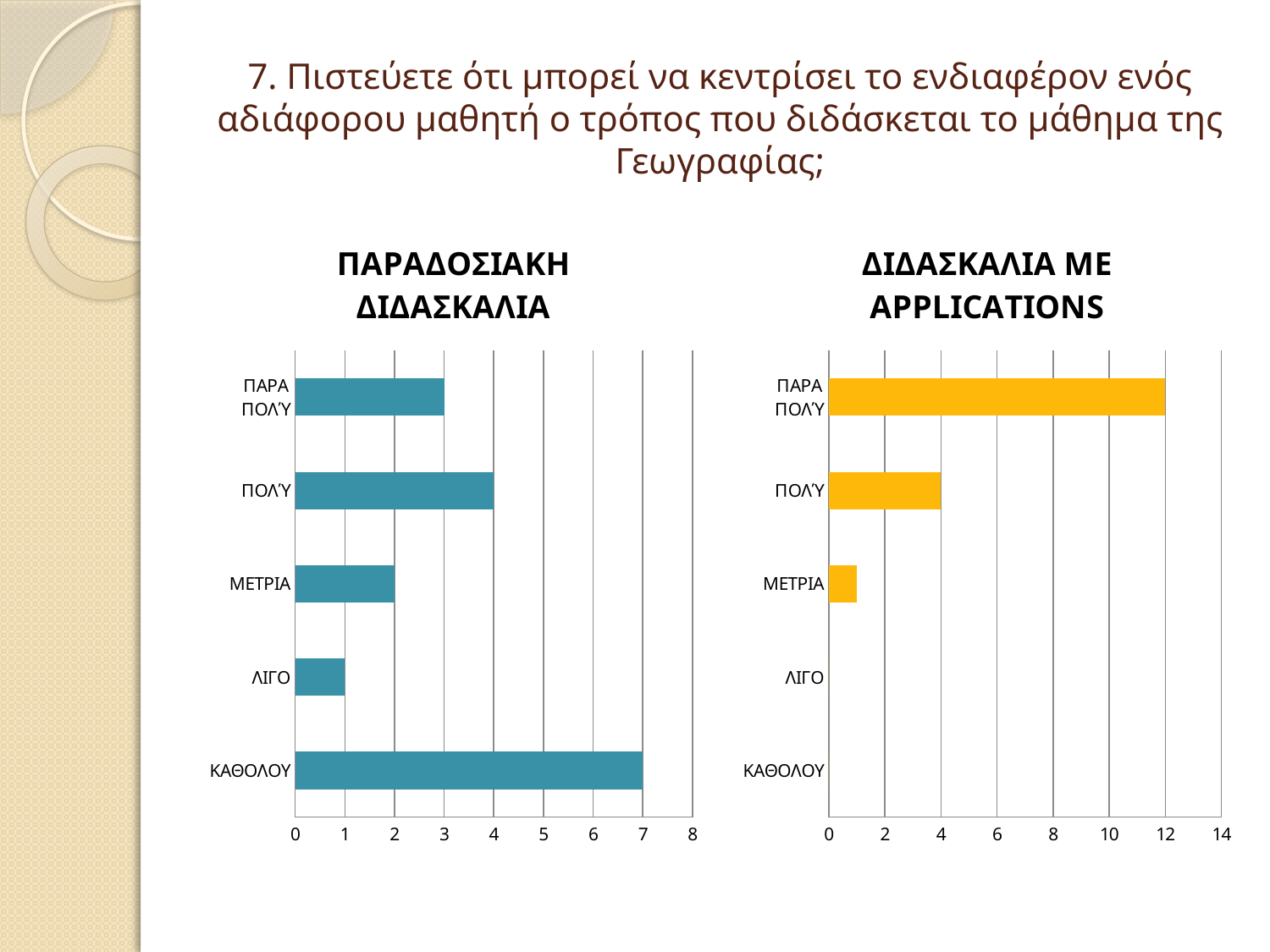
In the ΠΑΡΑΔΟΣΙΑΚΗ ΔΙΔΑΣΚΑΛΙΑ chart, which category has the lowest value? ΛΙΓΟ Which is larger: the value for ΠΑΡΑ ΠΟΛΎ in the ΠΑΡΑΔΟΣΙΑΚΗ ΔΙΔΑΣΚΑΛΙΑ chart or in the ΔΙΔΑΣΚΑΛΙΑ ΜΕ APPLICATIONS chart? ΔΙΔΑΣΚΑΛΙΑ ΜΕ APPLICATIONS In the ΔΙΔΑΣΚΑΛΙΑ ΜΕ APPLICATIONS chart, is the value for ΜΕΤΡΙΑ greater or less than 2? less In the ΠΑΡΑΔΟΣΙΑΚΗ ΔΙΔΑΣΚΑΛΙΑ chart, what is the difference between the values for ΚΑΘΟΛΟΥ and ΠΟΛΎ? 3 In the ΠΑΡΑΔΟΣΙΑΚΗ ΔΙΔΑΣΚΑΛΙΑ chart, what is the value for ΠΟΛΎ? 4 How many categories are shown in the ΠΑΡΑΔΟΣΙΑΚΗ ΔΙΔΑΣΚΑΛΙΑ chart? 5 What kind of chart is the ΔΙΔΑΣΚΑΛΙΑ ΜΕ APPLICATIONS chart? Bar chart In the ΔΙΔΑΣΚΑΛΙΑ ΜΕ APPLICATIONS chart, is the value for ΠΑΡΑ ΠΟΛΎ greater or less than 10? greater In the ΔΙΔΑΣΚΑΛΙΑ ΜΕ APPLICATIONS chart, what is the value for ΠΑΡΑ ΠΟΛΎ? 12 In the ΔΙΔΑΣΚΑΛΙΑ ΜΕ APPLICATIONS chart, which category has the highest value? ΠΑΡΑ ΠΟΛΎ In the ΠΑΡΑΔΟΣΙΑΚΗ ΔΙΔΑΣΚΑΛΙΑ chart, what is the value for ΚΑΘΟΛΟΥ? 7 In the ΠΑΡΑΔΟΣΙΑΚΗ ΔΙΔΑΣΚΑΛΙΑ chart, which category has the highest value? ΚΑΘΟΛΟΥ